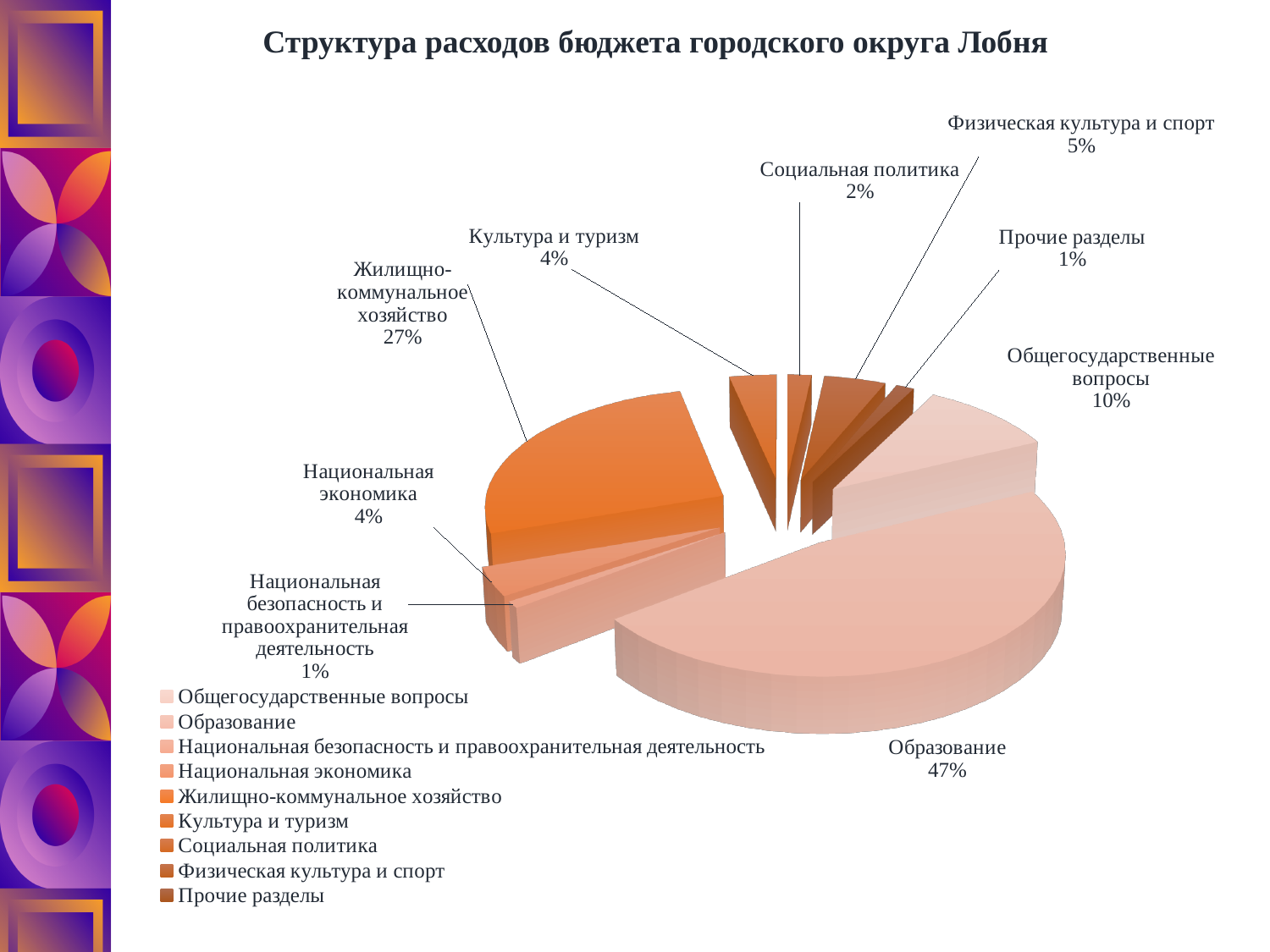
Which category has the largest share of the pie? Образование Which is larger, the share for Общегосударственные вопросы or the share for Физическая культура и спорт? Общегосударственные вопросы What percentage is shown for Общегосударственные вопросы? 10% What percentage is shown for Физическая культура и спорт? 5% What is the combined share of Национальная экономика and Культура и туризм? 8% What percentage is shown for Социальная политика? 2% What is the difference in percentage points between Образование and Жилищно-коммунальное хозяйство? 20 How many categories does the legend list? 9 What share of the budget expenditure goes to Образование? 47% What percentage is shown for Жилищно-коммунальное хозяйство? 27% What kind of chart is shown on the slide? pie chart What is the title of the chart? Структура расходов бюджета городского округа Лобня